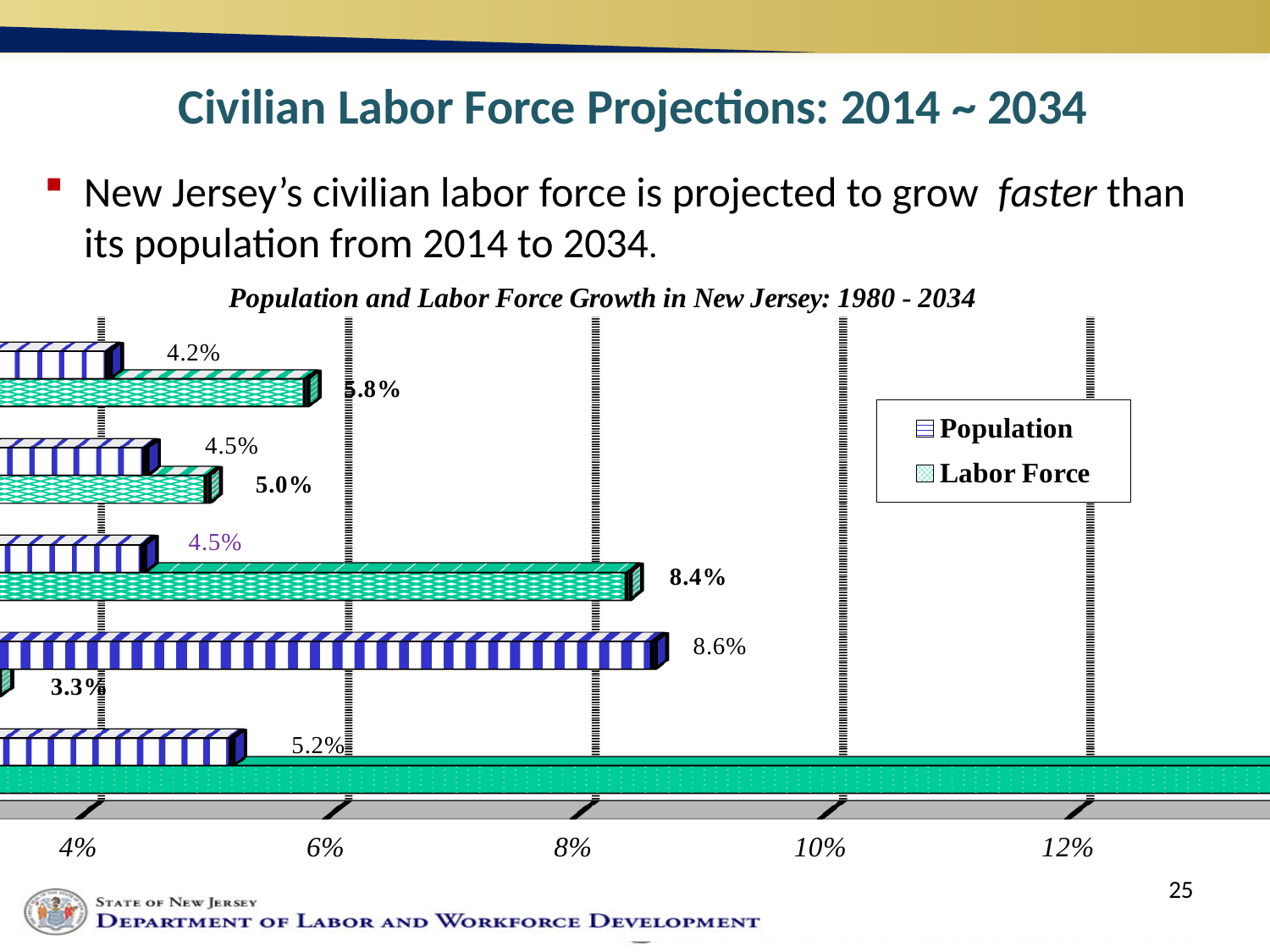
What is the highest Population value labeled on the chart? 8.6% What is the title of the chart on the slide? Population and Labor Force Growth in New Jersey: 1980 - 2034 What is the difference between the Labor Force value (5.8%) and the Population value (4.2%) in the topmost pair of bars? 1.6% What is the lowest Population value labeled on the chart? 4.2% What is the Population value labeled on the topmost pair of bars? 4.2% Is the Population bar labeled 8.6% greater or less than 8%? greater What kind of chart is shown on the slide? Bar chart What is the Labor Force value labeled on the topmost pair of bars? 5.8% In the topmost pair of bars, which is larger, the Population value or the Labor Force value? Labor Force Is the Labor Force bar labeled 3.3% greater or less than 4%? less How many series does the chart's legend list? 2 What are the two series named in the chart's legend? Population and Labor Force